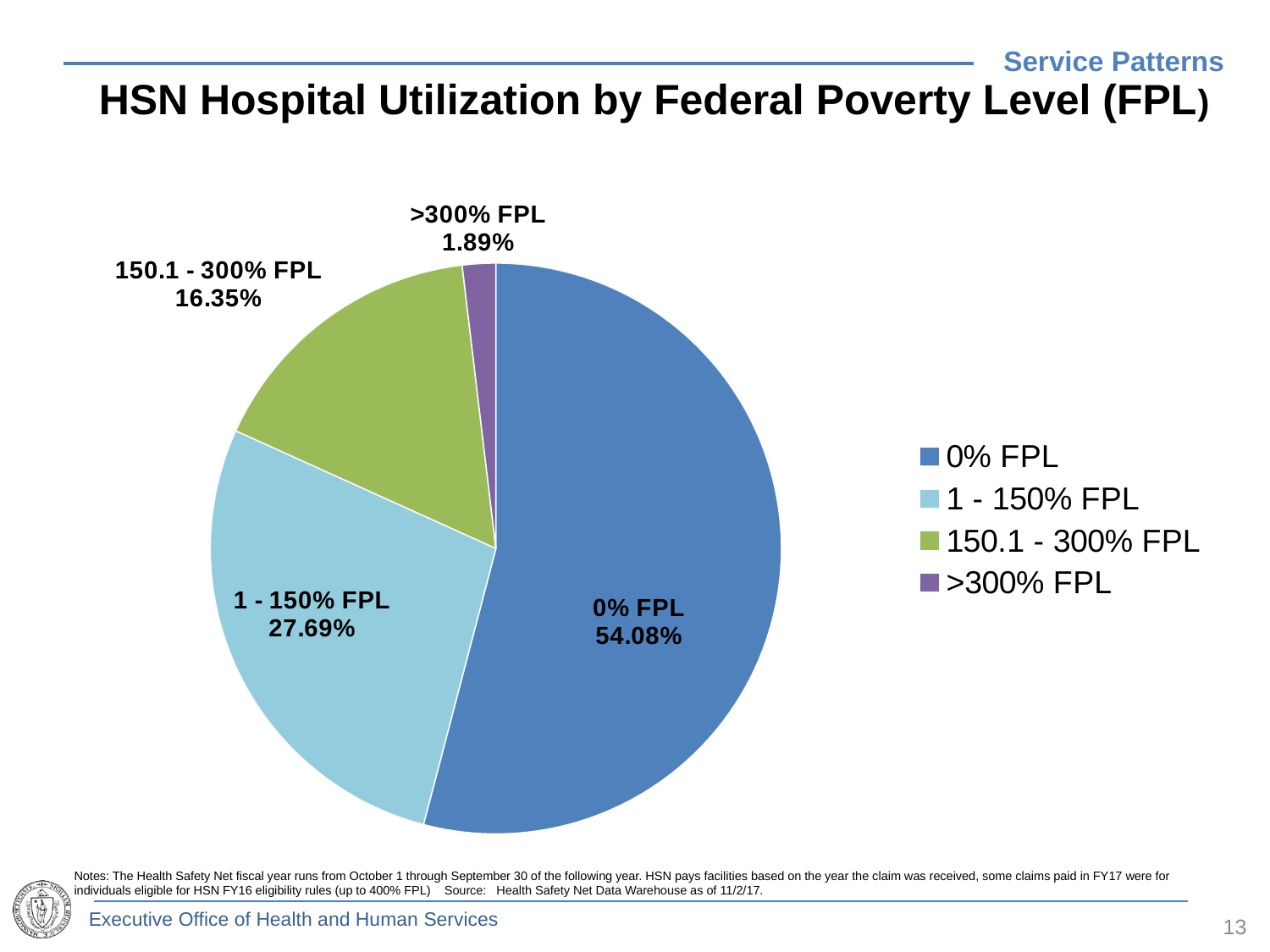
What share of HSN hospital utilization is for the >300% FPL group? 1.89% What colour is the slice for 150.1 - 300% FPL? green What is the title of the chart? HSN Hospital Utilization by Federal Poverty Level (FPL) What share of HSN hospital utilization is for the 0% FPL group? 54.08% What kind of chart is shown on the slide? pie chart What share of HSN hospital utilization is for the 1 - 150% FPL group? 27.69% Which FPL group has the largest share of HSN hospital utilization? 0% FPL Which has a larger share: 1 - 150% FPL or 150.1 - 300% FPL? 1 - 150% FPL Which FPL group has the smallest share of HSN hospital utilization? >300% FPL How many FPL categories are shown in the pie chart? 4 What share of HSN hospital utilization is for the 150.1 - 300% FPL group? 16.35% What is the difference in percentage points between the 0% FPL share and the 1 - 150% FPL share? 26.39